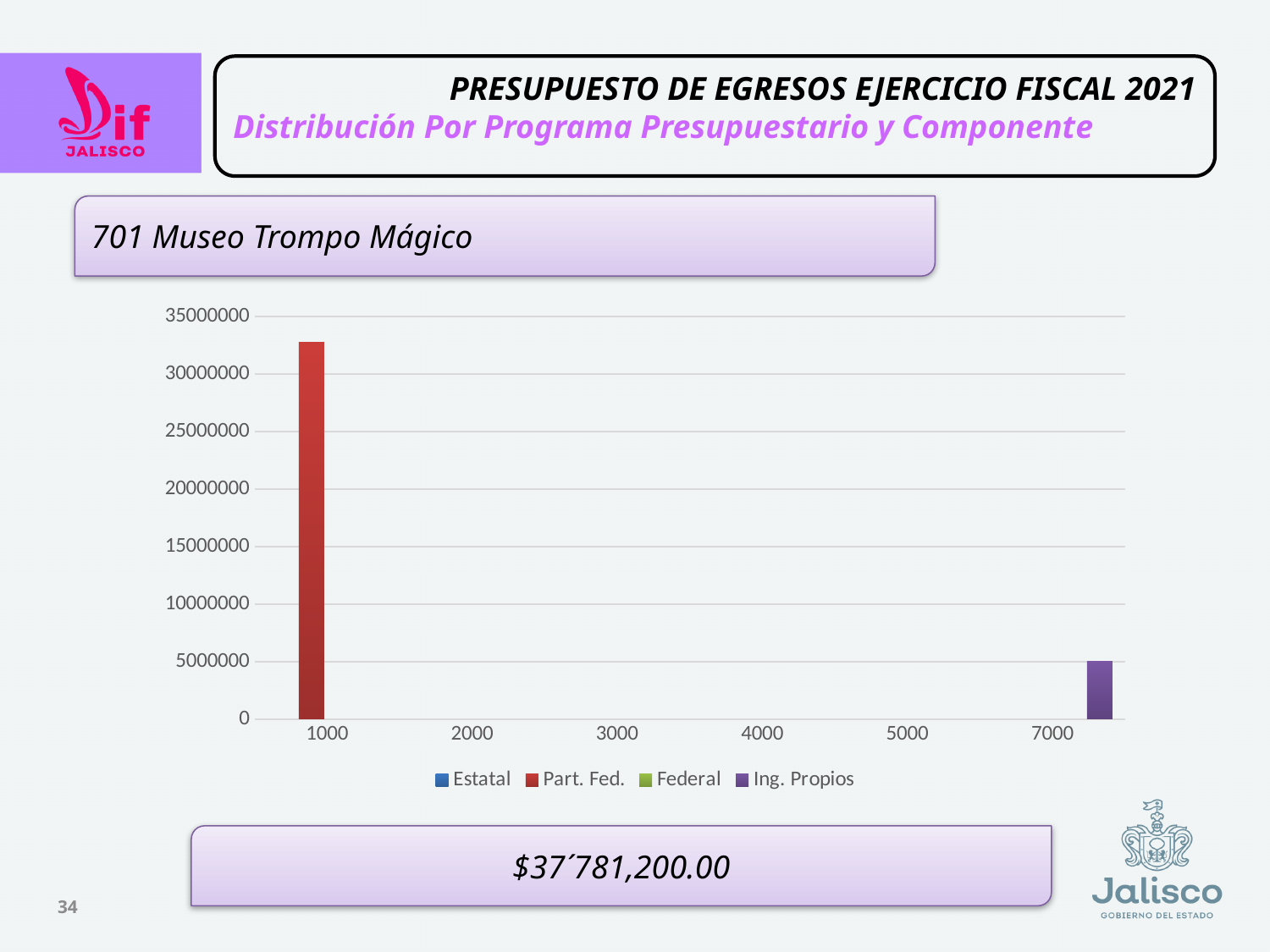
What colour represents the Part. Fed. series in the legend? red Which is larger, the bar for category 1000 or the bar for category 7000? 1000 How many series does the chart legend list? 4 Which series has a visible bar at category 7000? Ing. Propios How many categories are shown on the x axis of the chart? 6 Which category has the highest bar in the chart? 1000 Is the Part. Fed. value for category 1000 greater or less than 30000000? greater Which series has a visible bar at category 1000? Part. Fed. What is the title shown above the chart? 701 Museo Trompo Mágico What kind of chart is shown on the slide? bar chart Is the Part. Fed. value for category 1000 greater or less than 35000000? less Is the Ing. Propios value for category 7000 greater or less than 10000000? less